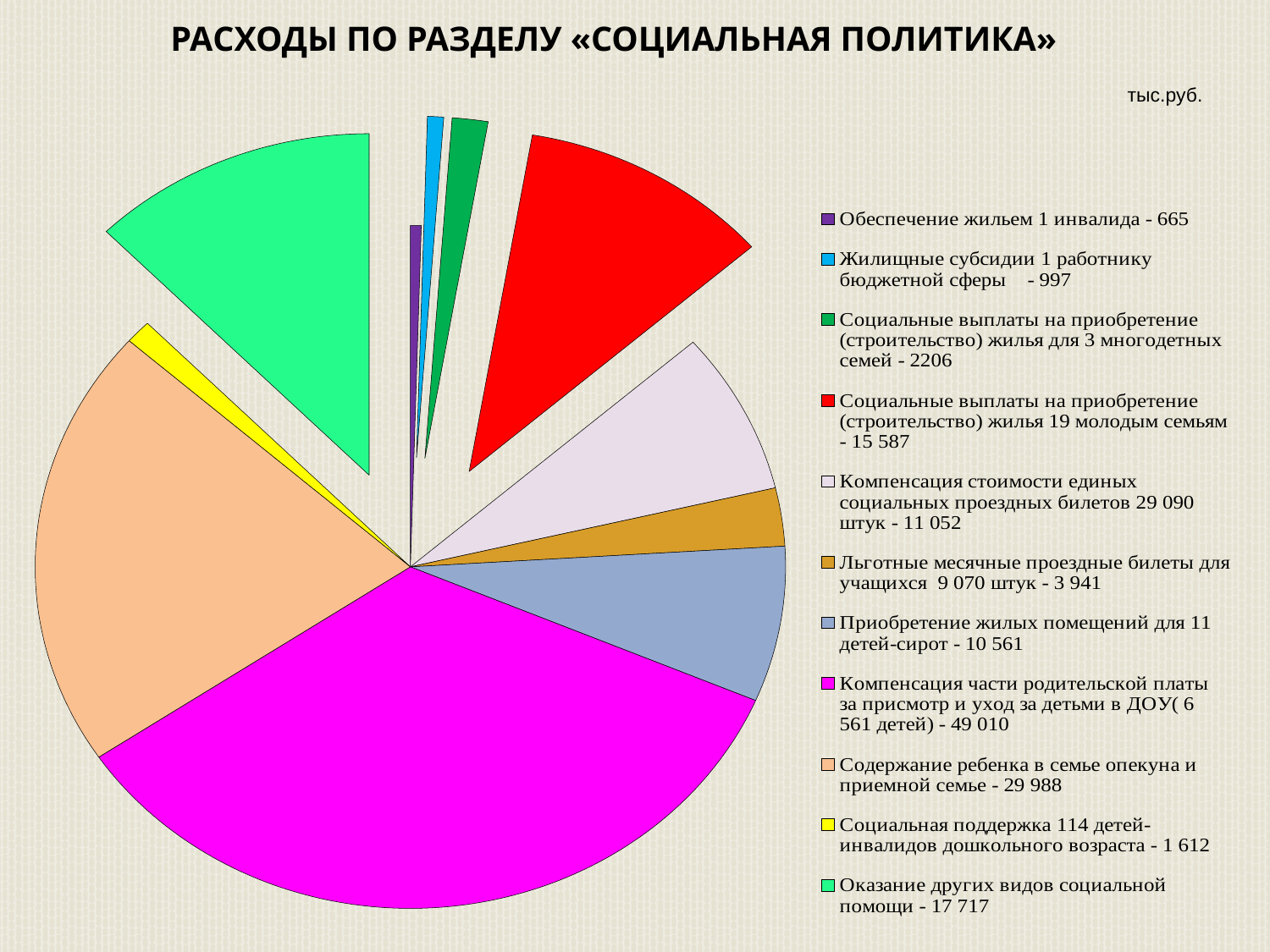
In what units are the values on the slide given? тыс.руб. Which category has the largest value in the pie chart? Компенсация части родительской платы за присмотр и уход за детьми в ДОУ Which is larger: «Оказание других видов социальной помощи» or «Социальные выплаты на приобретение (строительство) жилья 19 молодым семьям»? Оказание других видов социальной помощи Which category has the smallest value in the pie chart? Обеспечение жильем 1 инвалида How many categories does the pie chart have? 11 What colour is the slice for «Социальная поддержка 114 детей-инвалидов дошкольного возраста»? yellow What is the difference between «Компенсация части родительской платы за присмотр и уход за детьми в ДОУ» (49 010) and «Содержание ребенка в семье опекуна и приемной семье» (29 988)? 19 022 What is the value for «Оказание других видов социальной помощи»? 17 717 What is the value for «Компенсация части родительской платы за присмотр и уход за детьми в ДОУ»? 49 010 What is the value for «Содержание ребенка в семье опекуна и приемной семье»? 29 988 What is the value for «Приобретение жилых помещений для 11 детей-сирот»? 10 561 What kind of chart is shown on the slide? pie chart